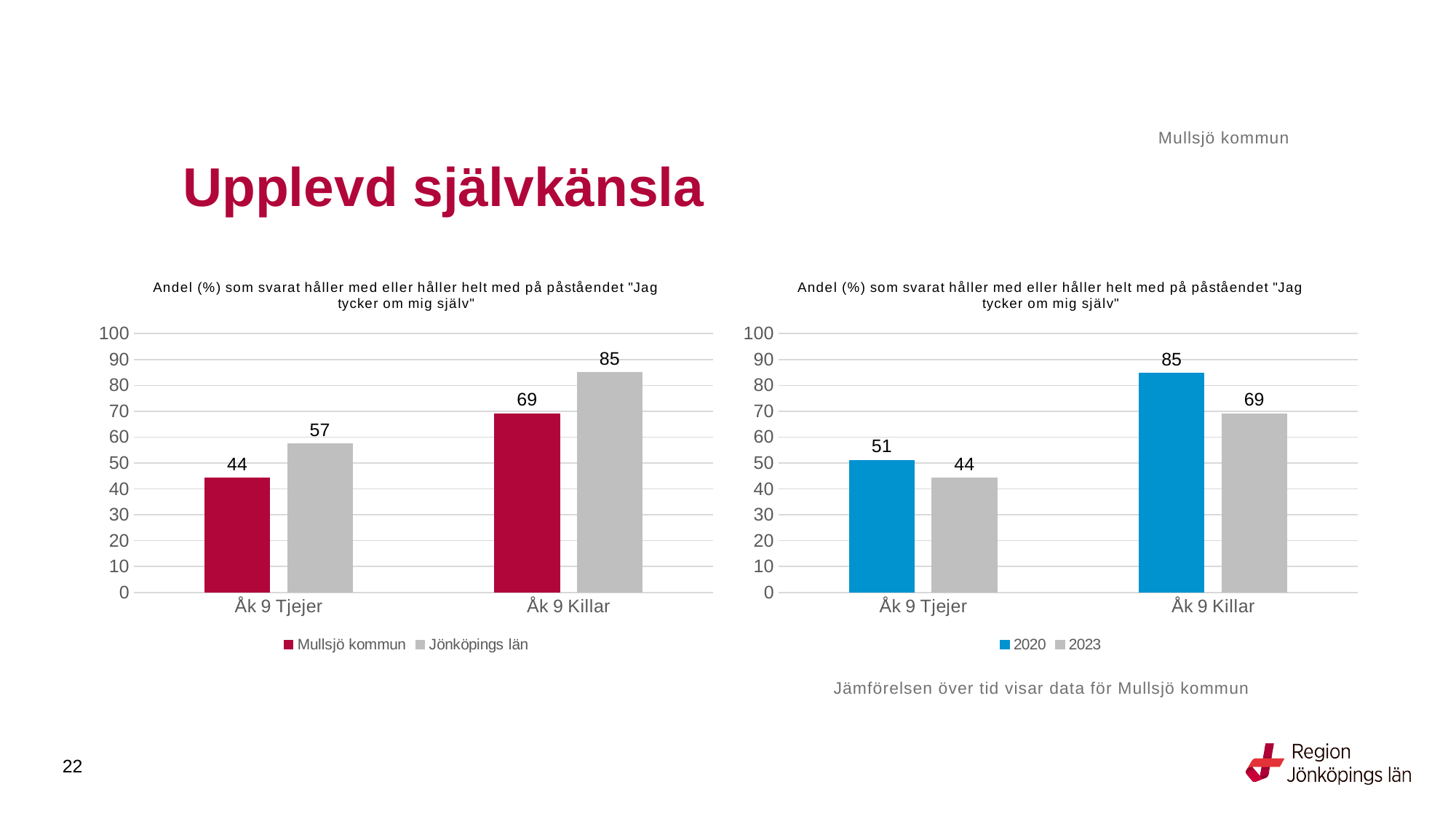
In the left chart, what is the value for Mullsjö kommun for Åk 9 Tjejer? 44 In the right chart, what is the value for 2020 for Åk 9 Tjejer? 51 In the right chart, which bar has the highest value? 2020, Åk 9 Killar In the left chart, which bar has the lowest value? Mullsjö kommun, Åk 9 Tjejer What kind of chart is the left chart? Bar chart In the left chart, what is the value for Jönköpings län for Åk 9 Killar? 85 In the right chart, what is the difference between the 2020 and 2023 values for Åk 9 Tjejer? 7 In the right chart, which year has the higher value for Åk 9 Killar? 2020 In the right chart, what is the value for 2023 for Åk 9 Killar? 69 How many series does the legend of the right chart list? 2 In the left chart, which is larger for Åk 9 Tjejer: Mullsjö kommun or Jönköpings län? Jönköpings län In the left chart, what is the difference between Jönköpings län and Mullsjö kommun for Åk 9 Killar? 16